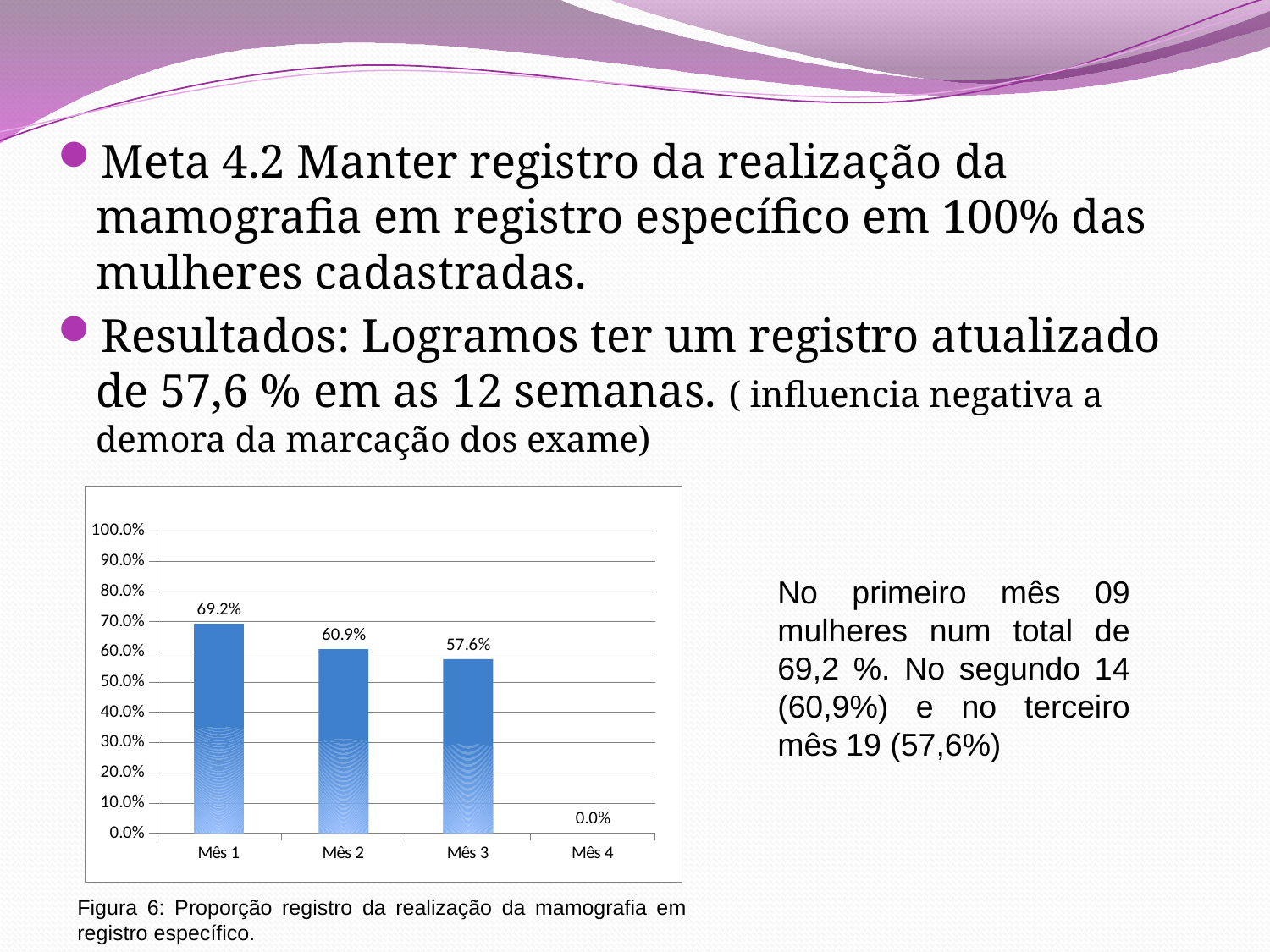
What is the value for Mês 3? 57.6% Which is larger, the value for Mês 1 or the value for Mês 2? Mês 1 What kind of chart is shown on the slide? Bar chart Which month has the lowest value? Mês 4 What is the value for Mês 4? 0.0% What is the value for Mês 1? 69.2% Do the values rise or fall from Mês 1 to Mês 3? Fall What is the difference between the values for Mês 1 and Mês 3? 11.6% Which month has the highest value? Mês 1 What is the difference between the values for Mês 2 and Mês 3? 3.3% How many categories are shown on the x axis of the chart? 4 What is the value for Mês 2? 60.9%